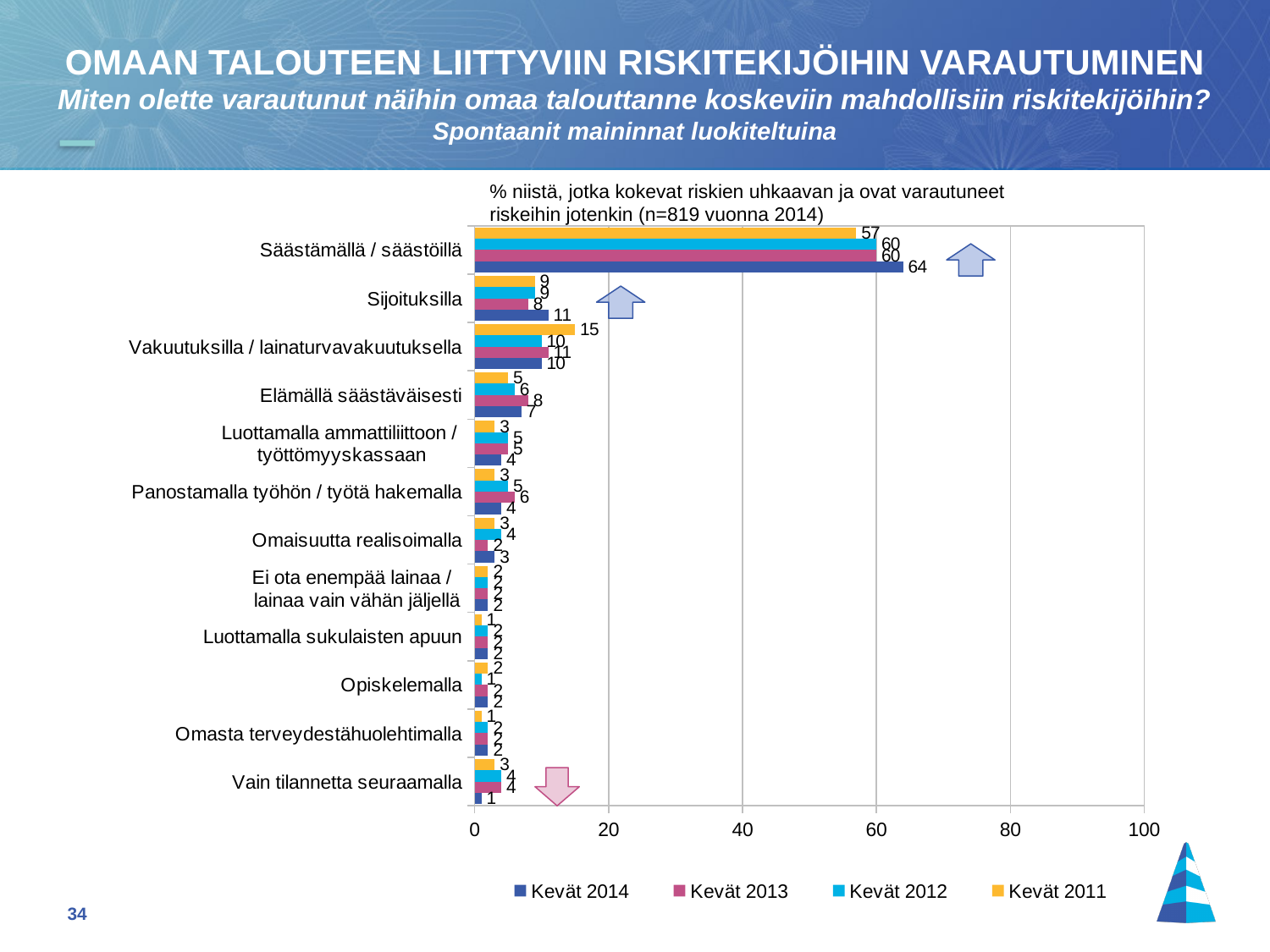
What is the value for Sijoituksilla in the Kevät 2014 series? 11 How many series does the legend list? 4 Which category has the highest value in the Kevät 2014 series? Säästämällä / säästöillä What is the value for Vakuutuksilla / lainaturvavakuutuksella in the Kevät 2011 series? 15 Which series is shown in yellow in the legend? Kevät 2011 Is the Kevät 2013 value for Säästämällä / säästöillä greater or less than 40? greater How many categories are shown on the vertical axis of the chart? 12 What is the difference between the Kevät 2014 and Kevät 2011 values for Säästämällä / säästöillä? 7 What is the value for Elämällä säästäväisesti in the Kevät 2013 series? 8 What kind of chart is shown on the slide? bar chart For Vain tilannetta seuraamalla, which is larger: the Kevät 2012 value or the Kevät 2014 value? Kevät 2012 What is the value for Säästämällä / säästöillä in the Kevät 2014 series? 64